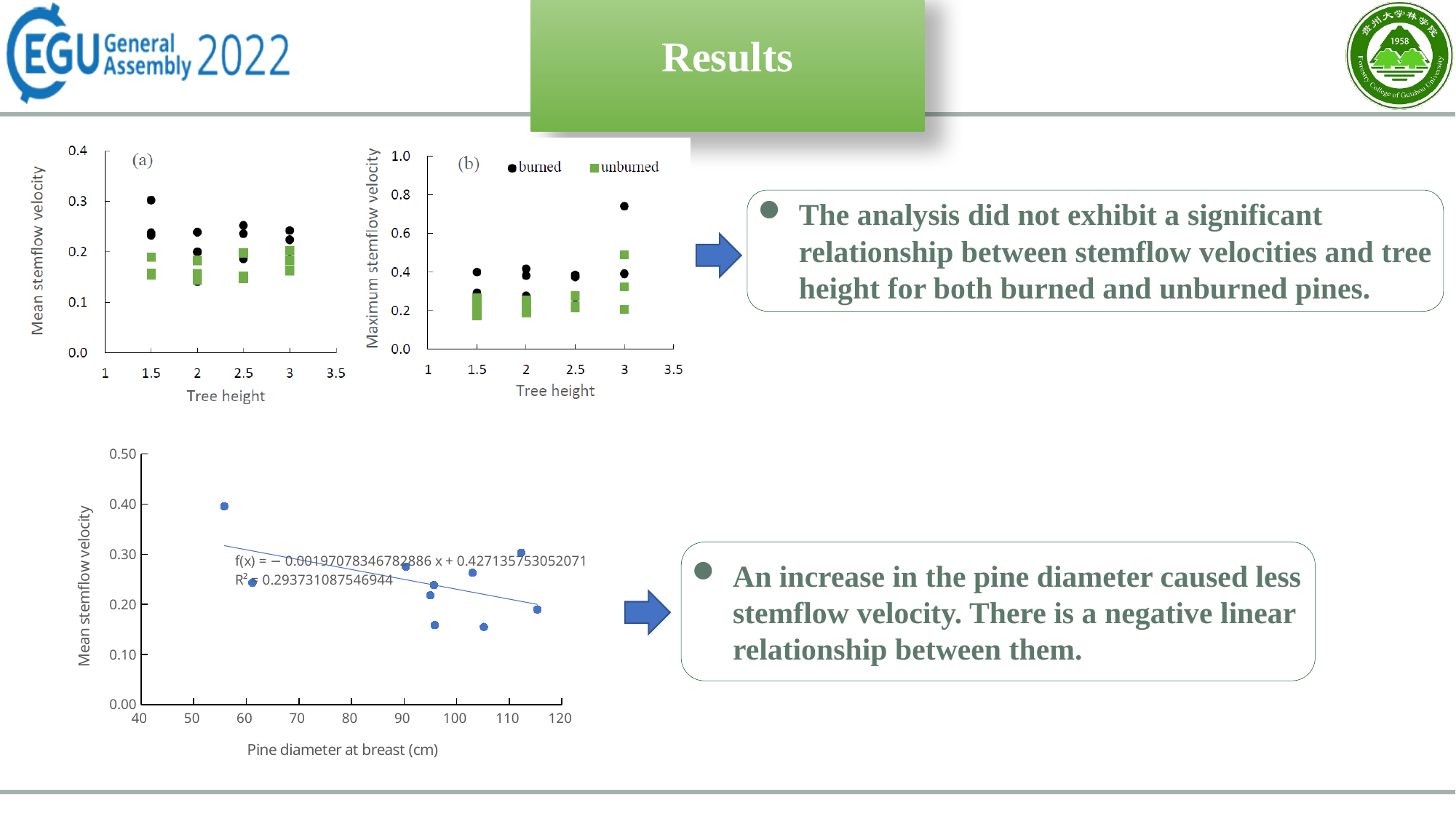
How many data points are plotted in the bottom chart? 10 In the bottom chart, is the highest plotted mean stemflow velocity greater or less than 0.30? greater In chart (a), is the highest burned mean stemflow velocity at tree height 1.5 greater or less than 0.2? greater What is the x-axis title of the bottom chart? Pine diameter at breast (cm) In the bottom chart, do the mean stemflow velocity values rise or fall as pine diameter increases along the x axis? fall What is the y-axis title of chart (b)? Maximum stemflow velocity What kind of chart is the bottom chart of mean stemflow velocity against pine diameter? scatter chart In chart (b), is the highest burned maximum stemflow velocity at tree height 3 greater or less than 0.6? greater How many series does the legend in chart (b) list? 2 What is the R² value printed on the bottom chart? 0.293731087546944